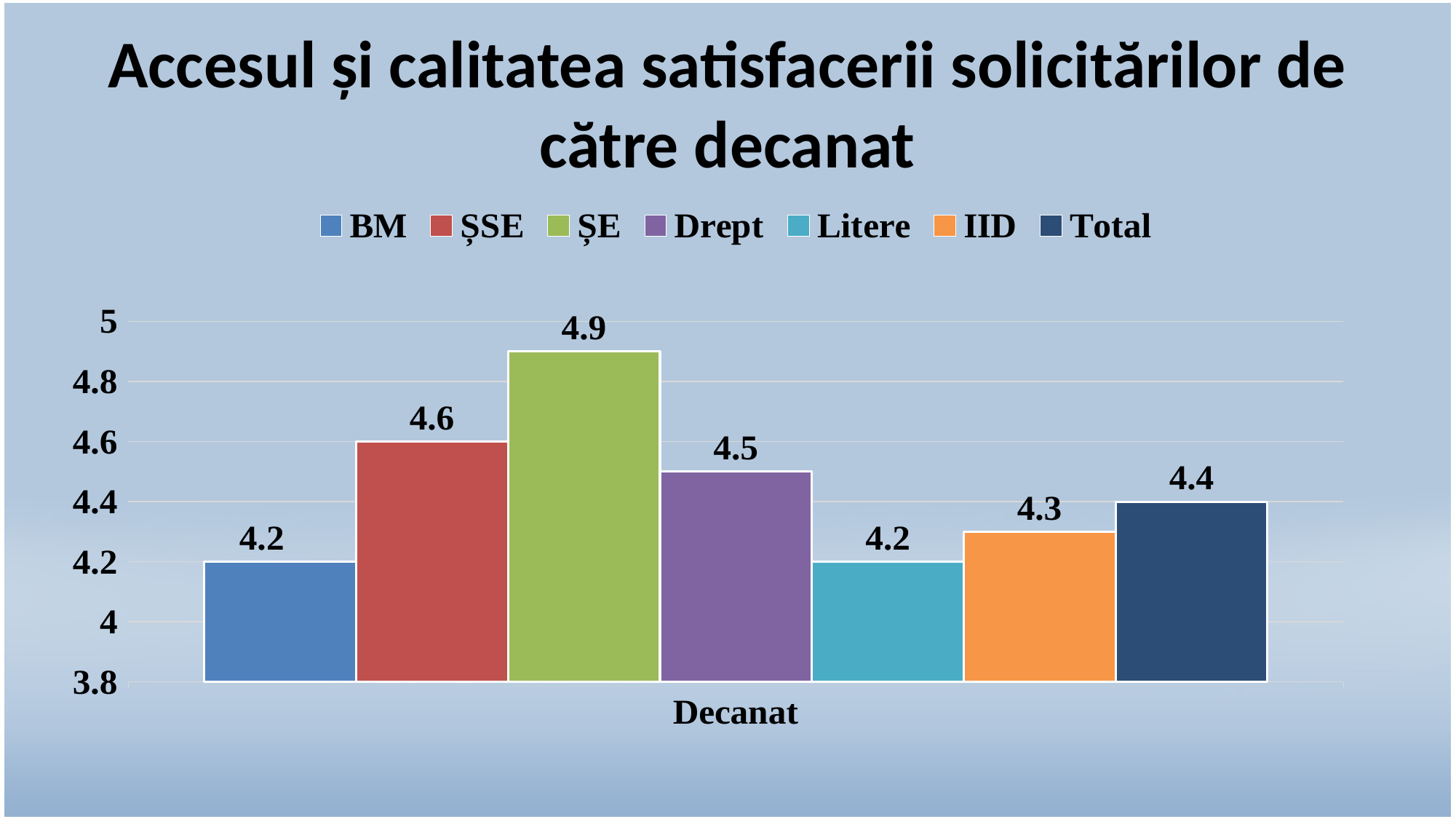
What is the difference between the values for ȘSE and Total? 0.2 Is the value for Litere greater or less than 4.4? less Which series has the highest value? ȘE What kind of chart is shown on the slide? bar chart Which is larger, the value for ȘSE or the value for Drept? ȘSE What is the difference between the values for ȘE and BM? 0.7 What is the label on the x axis of the chart? Decanat What is the value for Total? 4.4 How many series does the legend list? 7 What is the value for IID? 4.3 What is the value for Drept? 4.5 What is the value for ȘE? 4.9